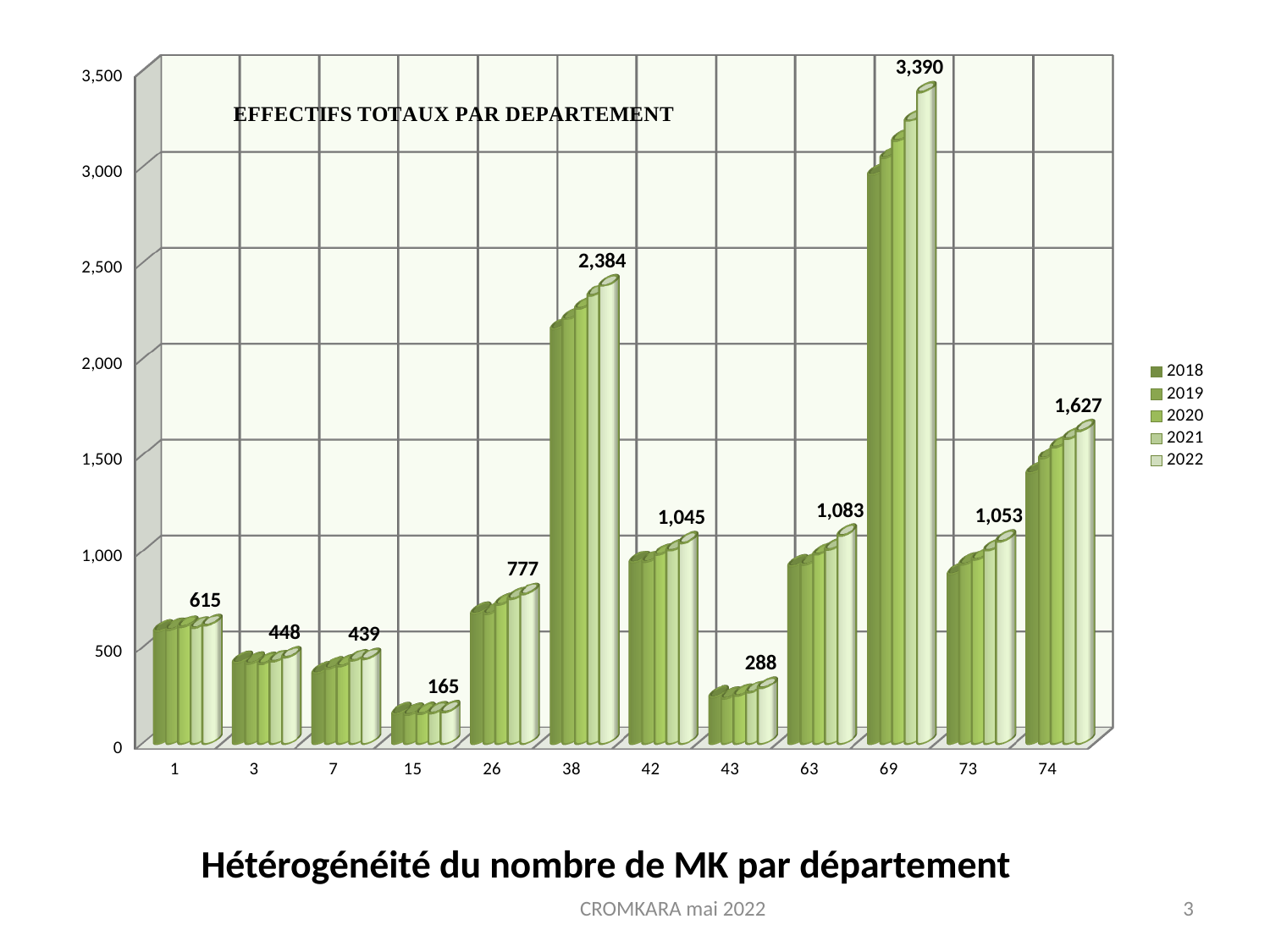
Is the 2018 value for department 69 greater or less than 2,500? greater Which department has the highest 2022 value? 69 What is the difference between the 2022 values for departments 69 and 38? 1,006 What is the 2022 value for department 38? 2,384 How many departments are shown on the x axis? 12 Which department has the lowest 2022 value? 15 What is the title printed inside the chart area? EFFECTIFS TOTAUX PAR DEPARTEMENT What is the 2022 value for department 15? 165 How many series does the legend list? 5 What is the 2022 value for department 69? 3,390 What kind of chart is shown? bar chart Which has the larger 2022 value, department 63 or department 73? 63